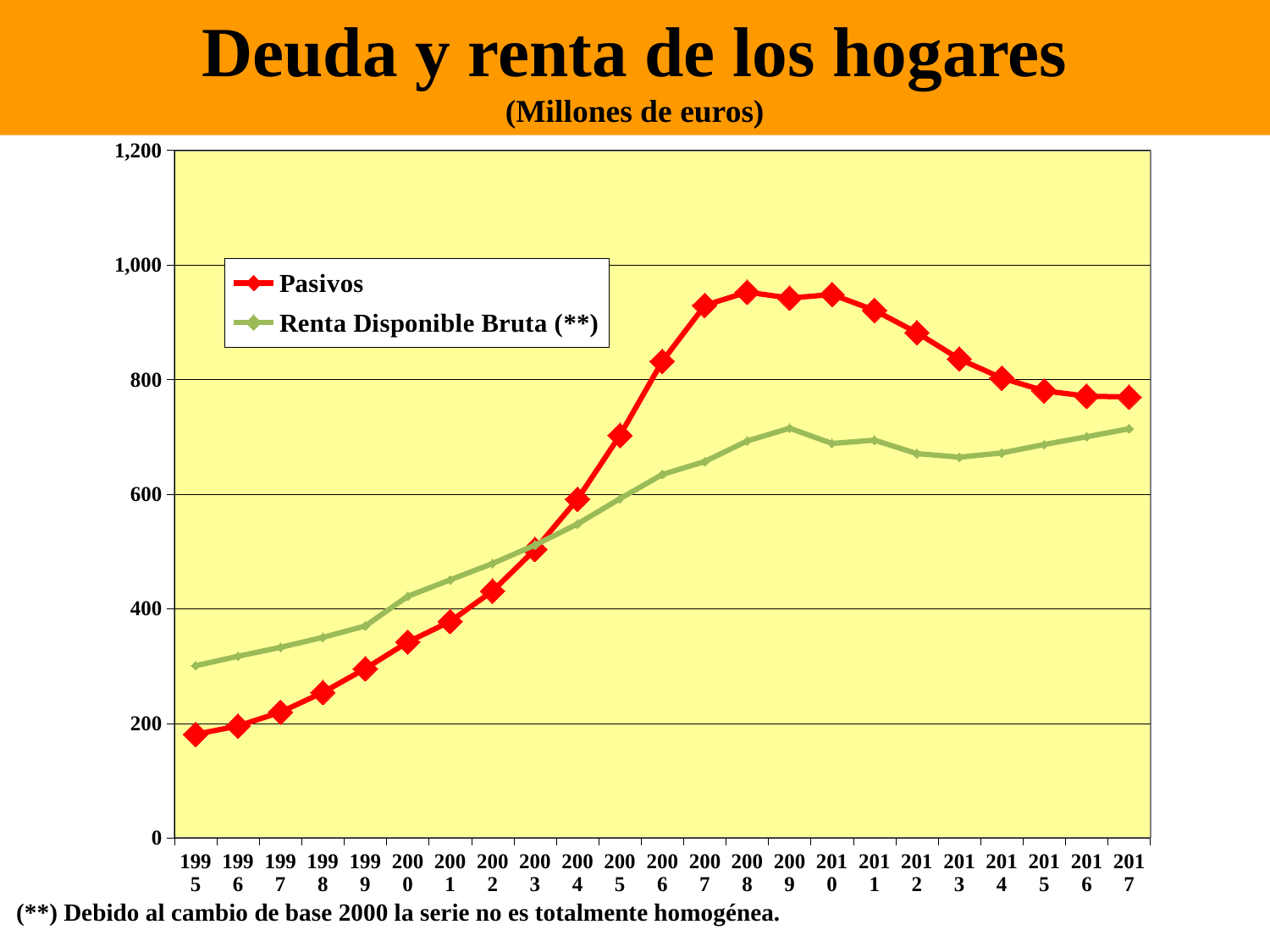
In which year is the Renta Disponible Bruta (**) series at its lowest? 1995 In 2008, which series has the larger value, Pasivos or Renta Disponible Bruta (**)? Pasivos What kind of chart is shown on the slide? Line chart In which year is the Pasivos series at its lowest? 1995 Is the value of Renta Disponible Bruta (**) in 1995 greater or less than 400? less Is the value of Pasivos in 2005 greater or less than 600? greater In 1995, which series has the larger value, Pasivos or Renta Disponible Bruta (**)? Renta Disponible Bruta (**) How many series does the legend list? 2 What is the title of the chart? Deuda y renta de los hogares Is the value of Pasivos in 2008 greater or less than 800? greater How many years are plotted along the x axis? 23 Which series is drawn in red? Pasivos